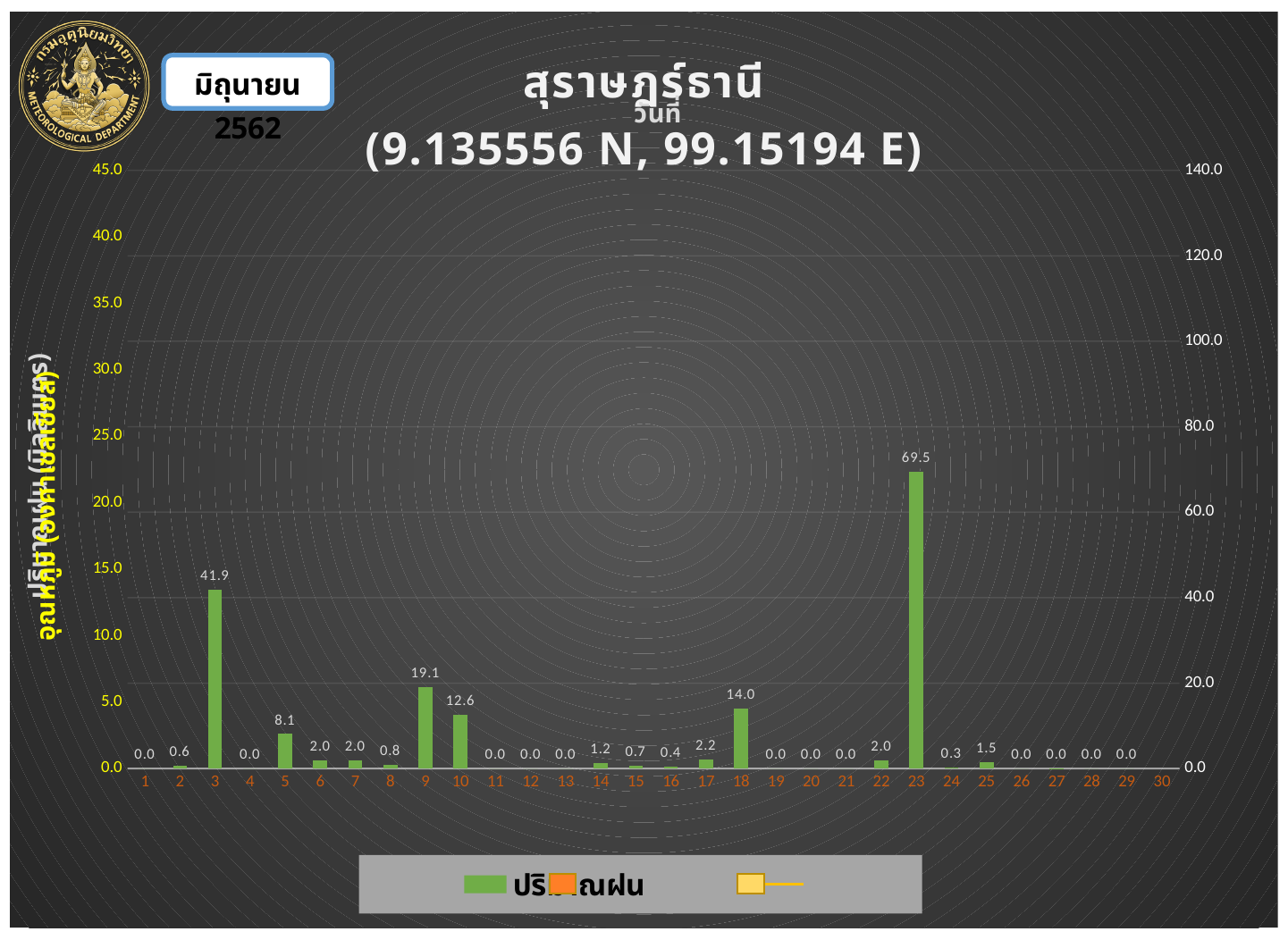
What is the value for day 10? 12.6 What coordinates are given in the chart title? 9.135556 N, 99.15194 E What is the difference between the values for day 9 and day 10? 6.5 Which is larger, the value for day 9 or the value for day 18? day 9 What is the value for day 9? 19.1 What is the value for day 18? 14.0 What is the value for day 3? 41.9 What is the value for day 23? 69.5 Which day has the highest value? 23 What kind of chart is this? bar chart How many days are shown on the x axis? 30 What is the difference between the values for day 23 and day 3? 27.6